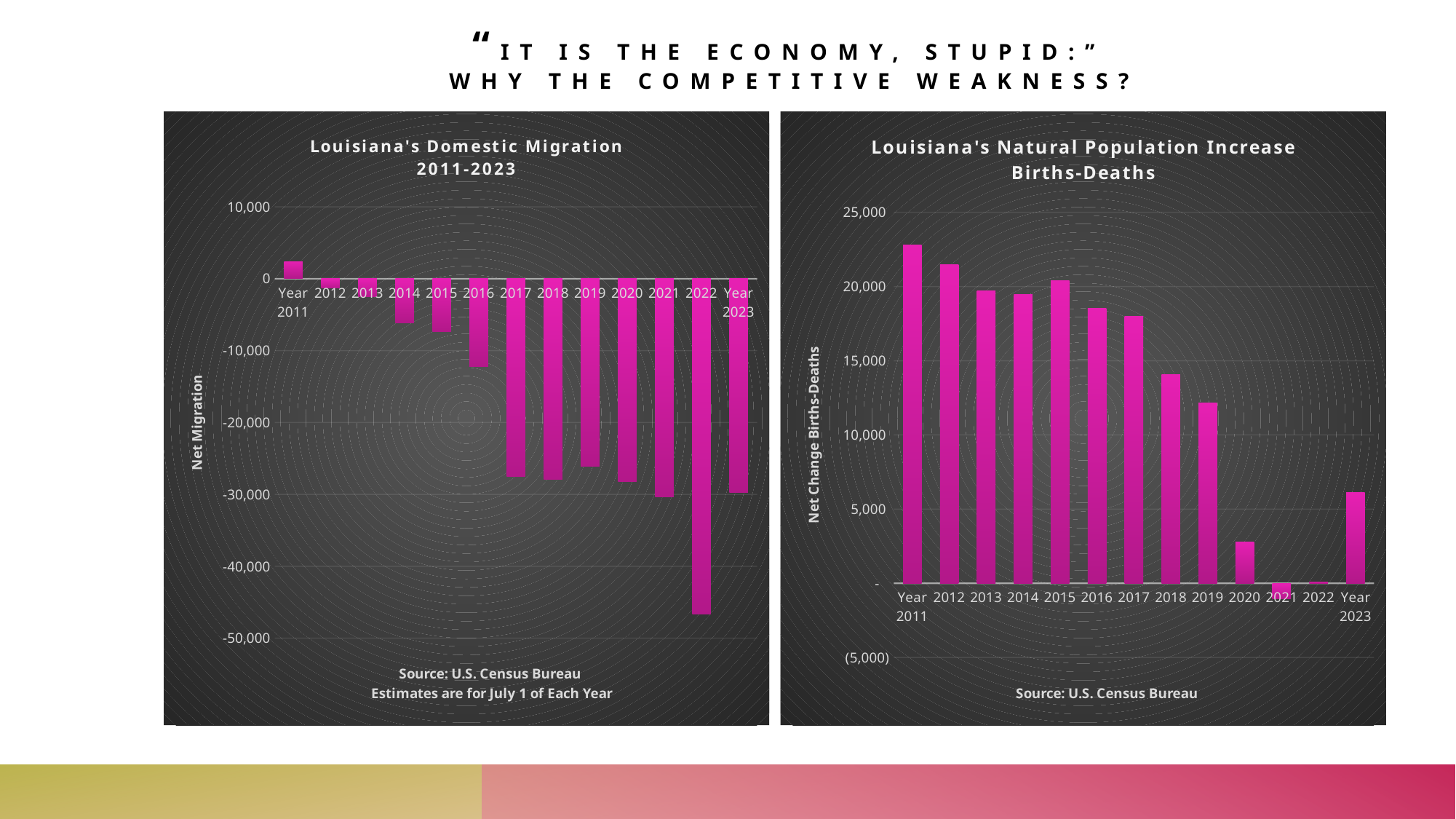
In the "Louisiana's Domestic Migration 2011-2023" chart, is the value for 2016 greater or less than -20,000? greater In the "Louisiana's Natural Population Increase Births-Deaths" chart, which year has the highest value? Year 2011 How many years are plotted in the "Louisiana's Domestic Migration 2011-2023" chart? 13 In the "Louisiana's Natural Population Increase Births-Deaths" chart, is the value for 2019 greater or less than 10,000? greater In the "Louisiana's Natural Population Increase Births-Deaths" chart, do the values generally rise or fall from 2011 to 2022? fall In the "Louisiana's Domestic Migration 2011-2023" chart, which year has the highest net migration? Year 2011 In the "Louisiana's Domestic Migration 2011-2023" chart, what is the label of the vertical axis? Net Migration In the "Louisiana's Domestic Migration 2011-2023" chart, which year has the lowest net migration? 2022 In the "Louisiana's Domestic Migration 2011-2023" chart, is the value for 2022 greater or less than -40,000? less In the "Louisiana's Natural Population Increase Births-Deaths" chart, which is larger, the value for 2015 or the value for 2018? 2015 What type of chart is "Louisiana's Domestic Migration 2011-2023"? bar chart